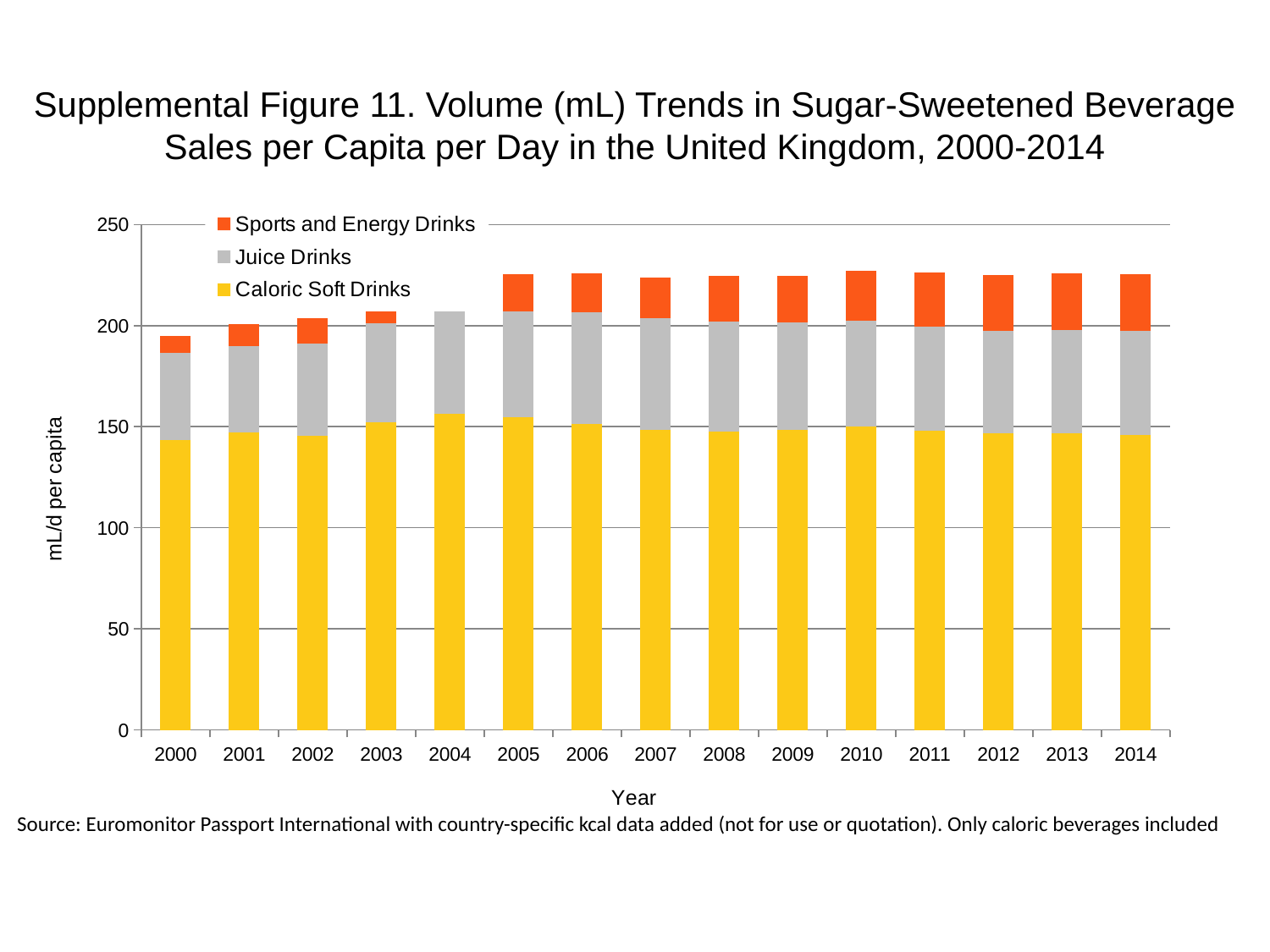
Is the total stacked bar for 2010 greater or less than 200? greater How many years are shown along the x axis? 15 Which year has the larger total stacked bar, 2000 or 2005? 2005 Which series does the legend list first? Sports and Energy Drinks Is the total stacked bar for 2000 greater or less than 200? less Does the total stacked bar rise or fall from 2000 to 2005? rise What is the label on the y axis? mL/d per capita Is the Caloric Soft Drinks value for 2000 greater or less than 150? less Which year has the lowest total stacked bar? 2000 What kind of chart is shown on the slide? Stacked bar chart How many series does the legend list? 3